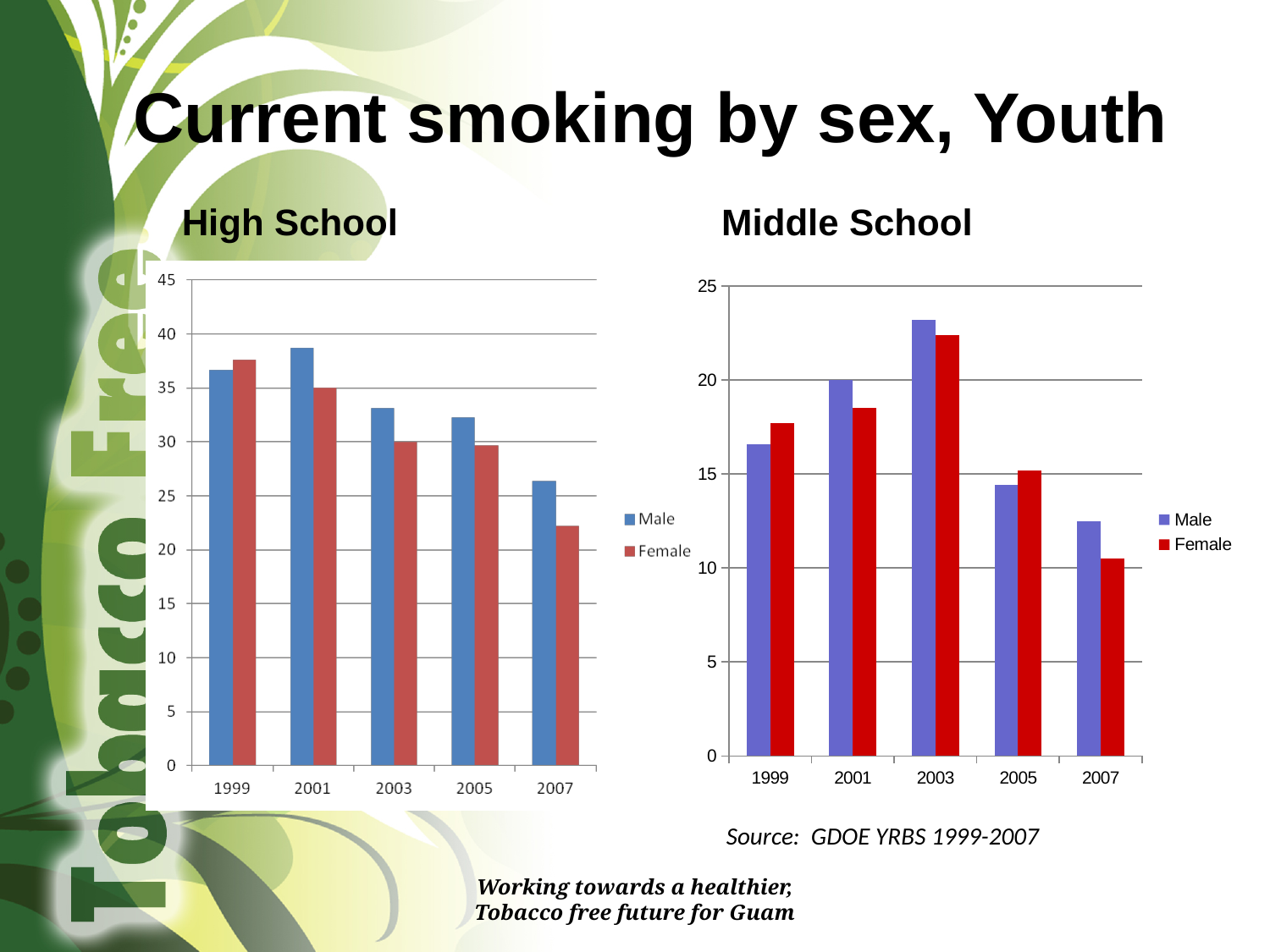
In the Middle School chart, which year has the lowest Female value? 2007 How many years are shown on the x axis of the Middle School chart? 5 In the Middle School chart, do the Male values rise or fall from 2003 to 2007? fall In the High School chart, which year has the highest Male value? 2001 In the Middle School chart, which year has the highest Male value? 2003 What kind of chart is the High School chart? bar chart In the High School chart, is the Male value for 2007 greater or less than 25? greater What is the source cited below the charts? GDOE YRBS 1999-2007 In the High School chart, which year has the lowest Female value? 2007 How many series does the legend of the High School chart list? 2 In the High School chart, which is larger in 2001, Male or Female? Male